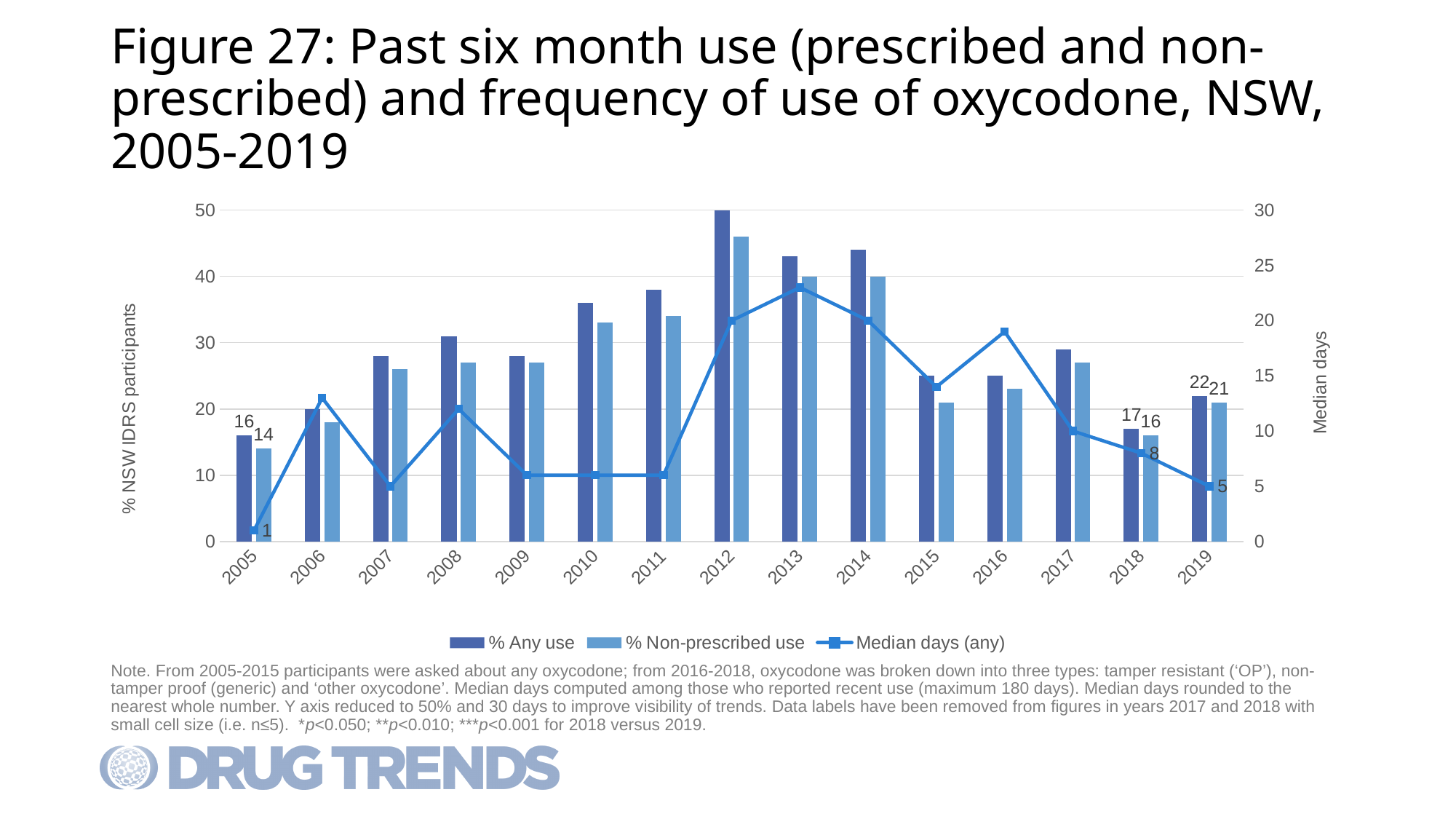
Is the % Non-prescribed use value for 2016 greater or less than 30? less What is the Median days (any) value in 2018? 8 Which year has the lowest Median days (any) value? 2005 What is the value for % Any use in 2005? 16 How many years are shown on the x axis? 15 What is the Median days (any) value in 2005? 1 How many series does the legend list? 3 What is the difference between % Any use and % Non-prescribed use in 2019? 1 Is the % Any use value for 2012 greater or less than 40? greater What is the value for % Non-prescribed use in 2019? 21 Which year has the highest % Any use bar? 2012 Which is larger, the % Any use value in 2013 or in 2017? 2013